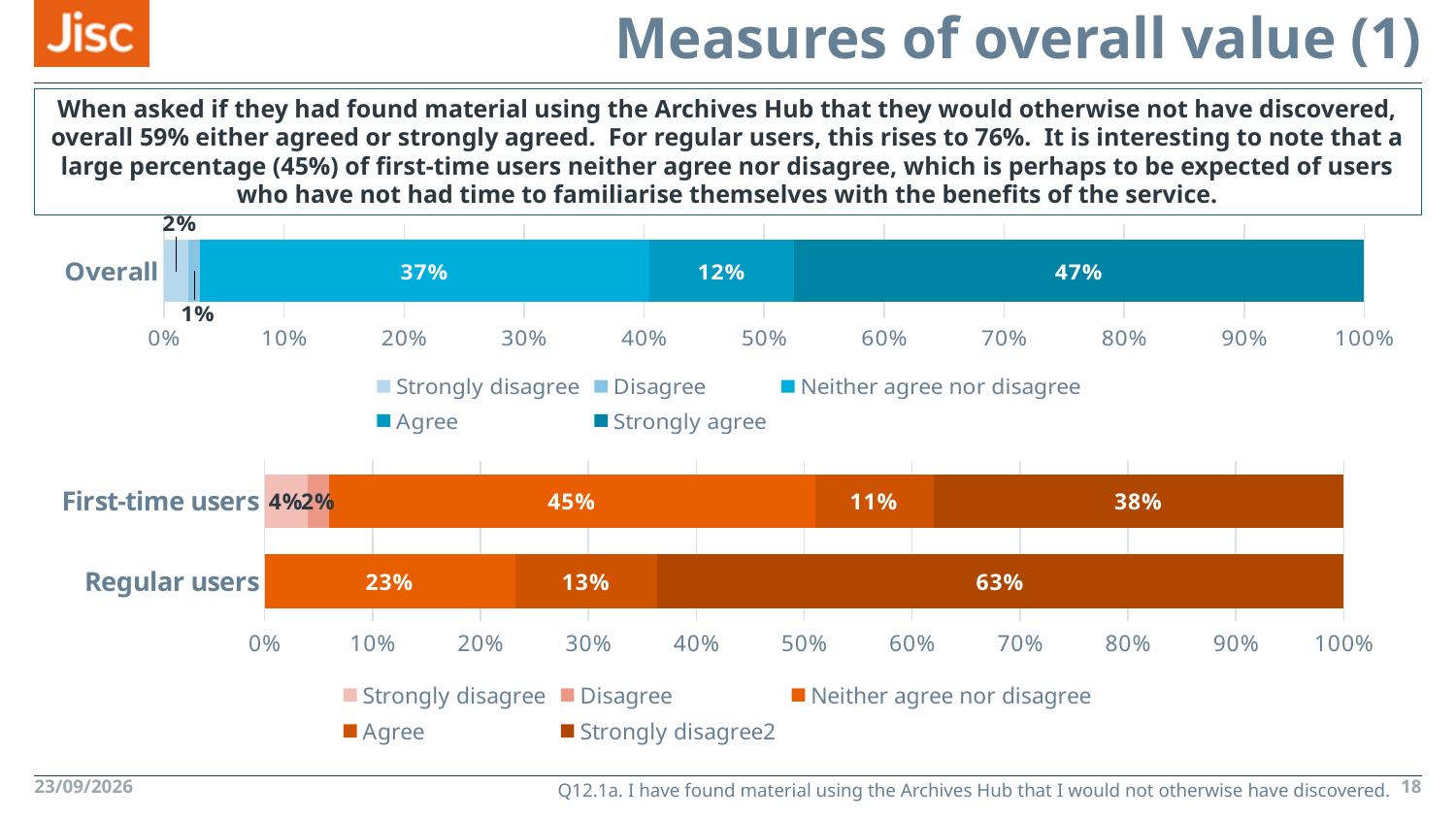
In the top chart, what is the value of the Neither agree nor disagree segment for Overall? 37% In the top chart, what is the value of the Strongly agree segment for Overall? 47% What kind of chart is the bottom chart? Stacked bar chart How many series does the legend of the top chart list? 5 In the bottom chart, what is the Agree value for Regular users? 13% In the bottom chart, what is the difference between the Neither agree nor disagree values for First-time users and Regular users? 22 percentage points In the bottom chart, which group has the larger Agree value, First-time users or Regular users? Regular users In the bottom chart, which group has the higher Neither agree nor disagree value? First-time users In the top chart, what is the value of the Agree segment for Overall? 12% In the bottom chart, what is the Neither agree nor disagree value for First-time users? 45% How many user groups are shown in the bottom chart? 2 In the bottom chart, what is the value of the largest segment for Regular users? 63%